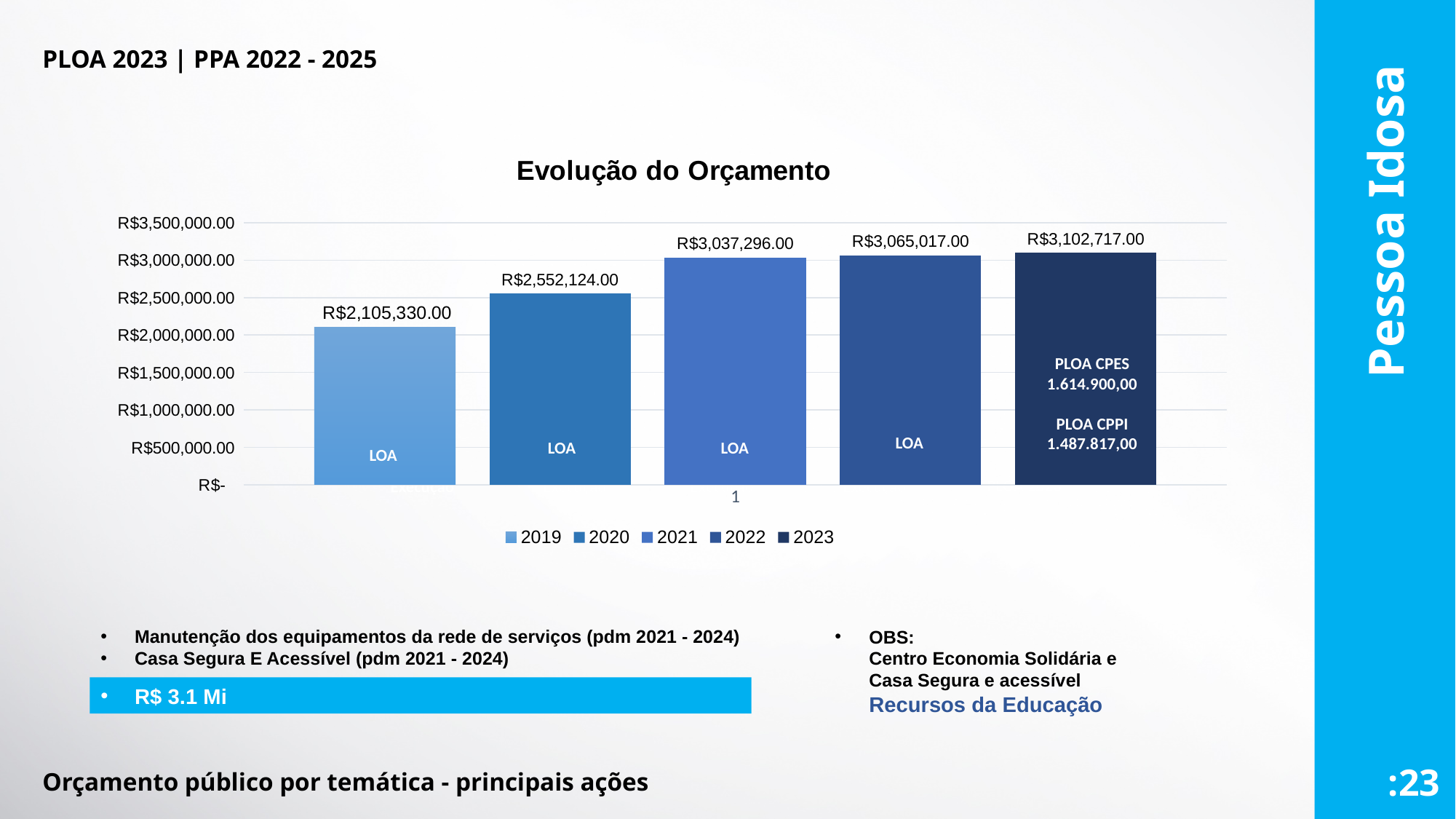
What is the value for 2021 in the Evolução do Orçamento chart? R$3,037,296.00 What is the difference between the 2020 and 2019 values in the Evolução do Orçamento chart? R$446,794.00 How many series does the legend of the Evolução do Orçamento chart list? 5 Which year has the highest value in the Evolução do Orçamento chart? 2023 What is the value for 2023 in the Evolução do Orçamento chart? R$3,102,717.00 Is the value for 2019 in the Evolução do Orçamento chart greater or less than R$2,500,000.00? less What is the value for 2019 in the Evolução do Orçamento chart? R$2,105,330.00 What is the difference between the 2023 and 2022 values in the Evolução do Orçamento chart? R$37,700.00 Do the values in the Evolução do Orçamento chart rise or fall from 2019 to 2023? rise What kind of chart is Evolução do Orçamento? bar chart Which is larger in the Evolução do Orçamento chart, the value for 2021 or the value for 2022? 2022 Which year has the lowest value in the Evolução do Orçamento chart? 2019